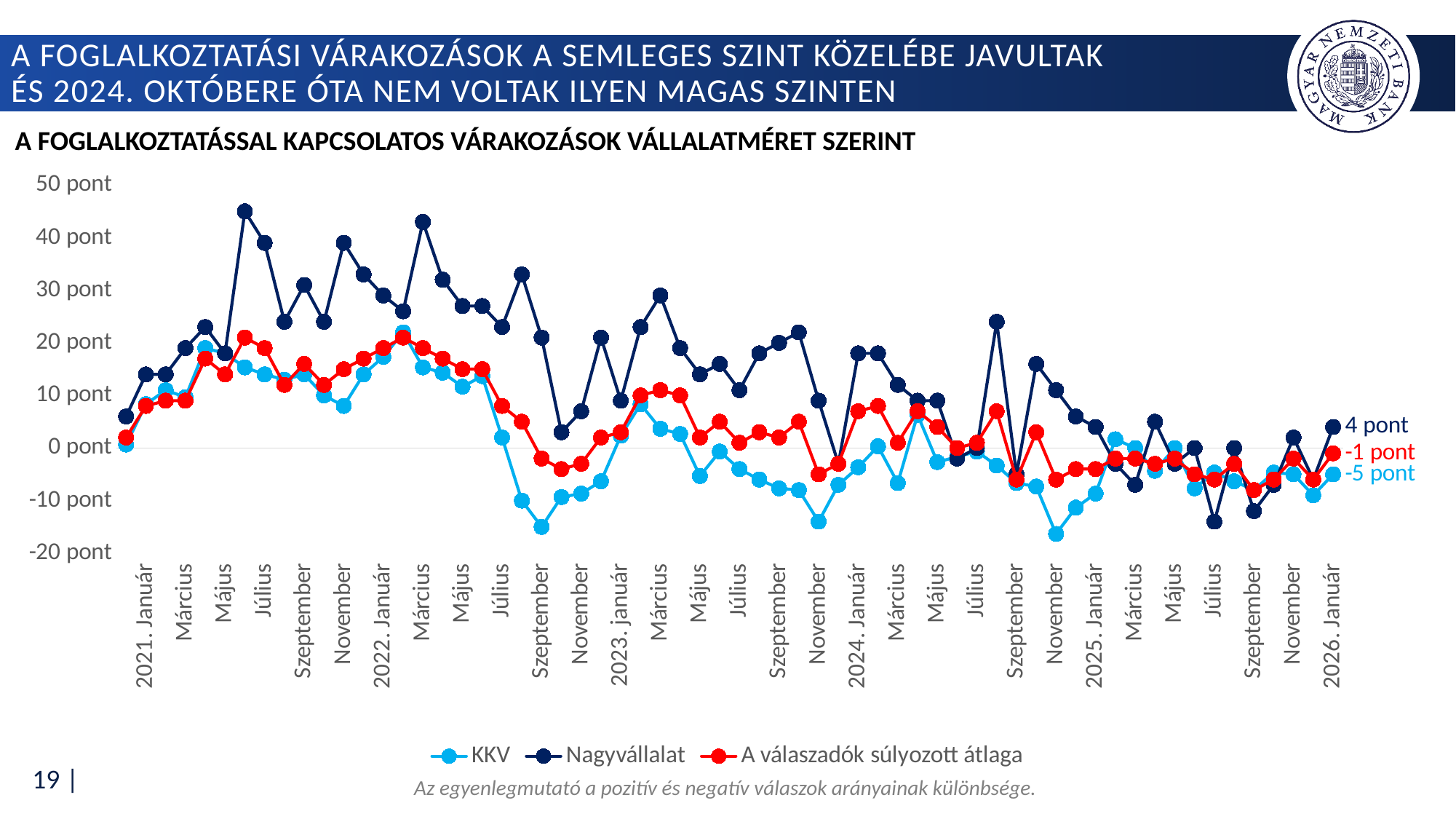
What is the value of 'A válaszadók súlyozott átlaga' at 2026. Január? -1 pont What is the value of the Nagyvállalat series at 2026. Január? 4 pont Which series has the lowest value at 2026. Január? KKV At 2026. Január, what is the difference between the Nagyvállalat value and the weighted average (A válaszadók súlyozott átlaga)? 5 pont How many series does the legend list? 3 Is the highest value reached by the Nagyvállalat series greater or less than 40 pont? greater Is the lowest value reached by the KKV series greater or less than -10 pont? less At 2026. Január, which series has the higher value, KKV or Nagyvállalat? Nagyvállalat What kind of chart is shown on the slide? line chart Does the Nagyvállalat series generally rise or fall from 2021 to 2026? fall At 2026. Január, what is the difference between the Nagyvállalat value and the KKV value? 9 pont What is the value of the KKV series at 2026. Január? -5 pont